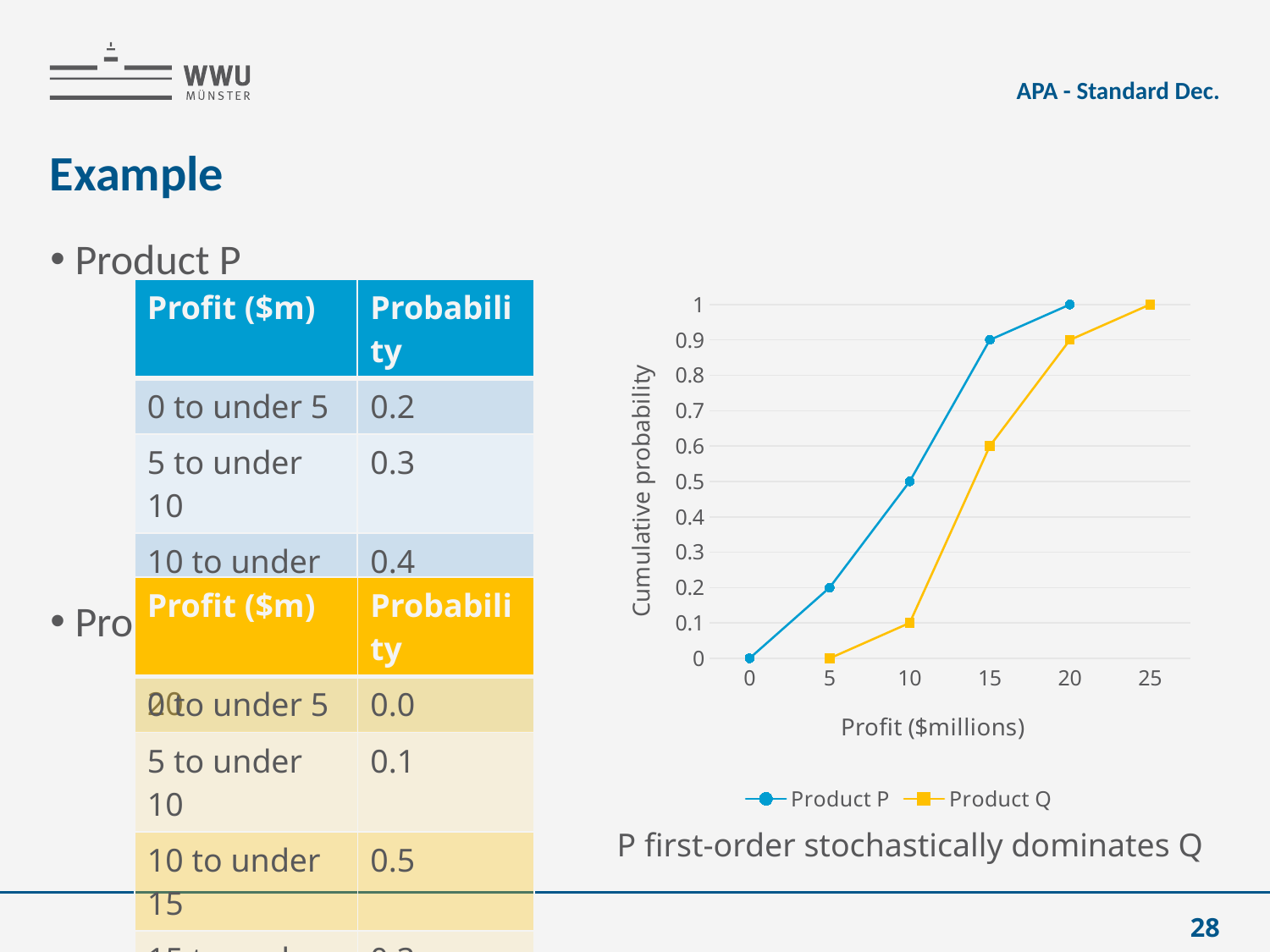
Is the cumulative probability for Product Q at a profit of 10 ($millions) greater or less than 0.5? less What is the cumulative probability for Product Q at a profit of 20 ($millions)? 0.9 What is the cumulative probability for Product P at a profit of 10 ($millions)? 0.5 Do the cumulative probability values for Product P rise or fall as profit increases along the x axis? rise What kind of chart is shown on the slide? line chart What is the difference between the cumulative probabilities of Product P and Product Q at a profit of 10 ($millions)? 0.4 What is the label of the chart's x axis? Profit ($millions) How many series does the chart's legend list? 2 What is the cumulative probability for Product P at a profit of 5 ($millions)? 0.2 What is the label of the chart's y axis? Cumulative probability At a profit of 15 ($millions), which series has the higher cumulative probability, Product P or Product Q? Product P What is the cumulative probability for Product Q at a profit of 15 ($millions)? 0.6